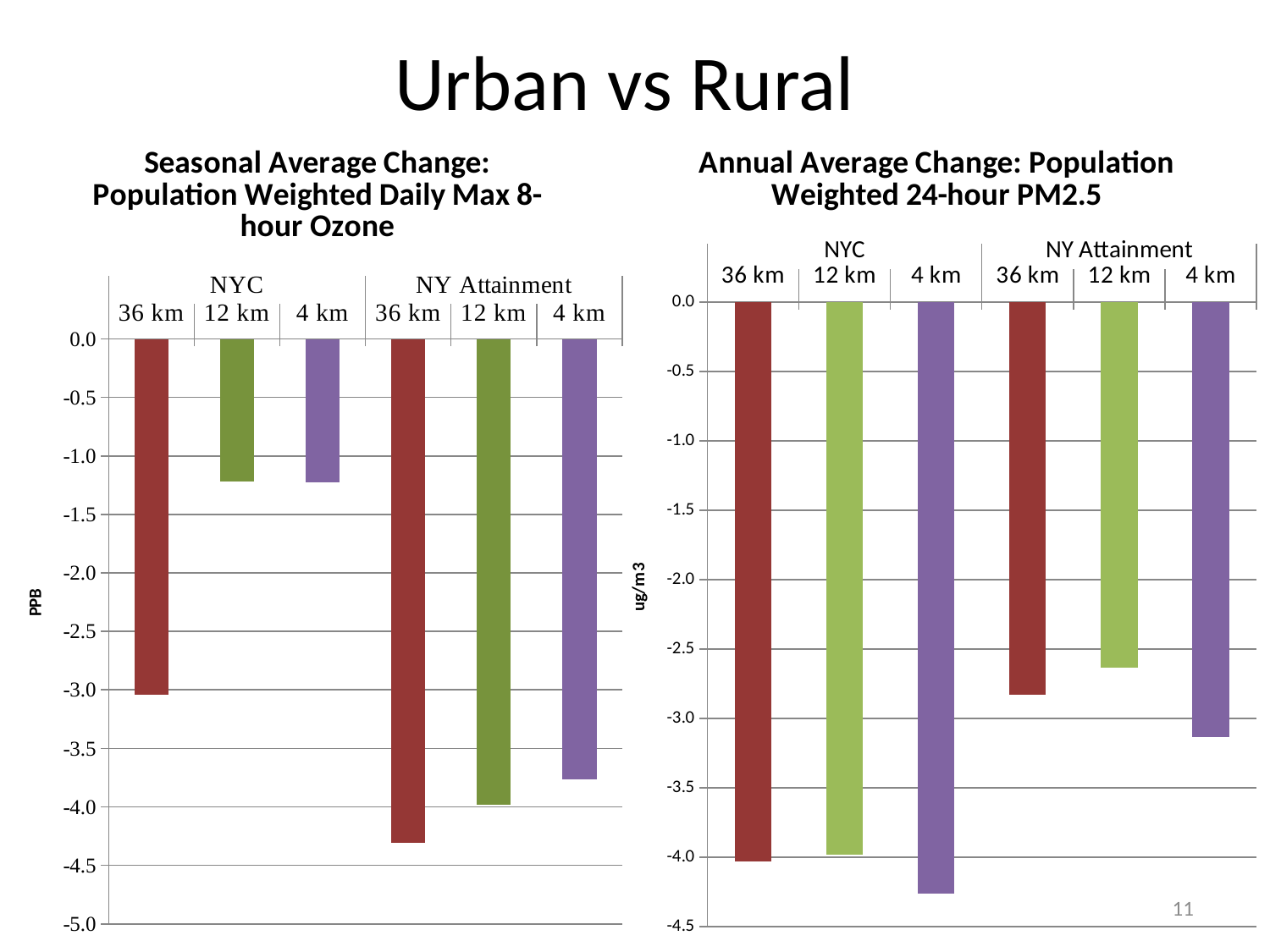
In the PM2.5 chart on the right, is the value for NYC 4 km greater or less than -4.0? less In the Ozone chart on the left, is the value for NY Attainment 36 km greater or less than -4.0? less In the PM2.5 chart on the right, is the value for NY Attainment 12 km greater or less than -3.0? greater In the Ozone chart on the left, which is larger, the value for NYC 12 km or the value for NY Attainment 12 km? NYC 12 km In the PM2.5 chart on the right, which is larger, the value for NYC 36 km or the value for NY Attainment 36 km? NY Attainment 36 km In the PM2.5 chart on the right, which bar has the lowest (most negative) value? NYC 4 km What kind of chart is the 'Seasonal Average Change: Population Weighted Daily Max 8-hour Ozone' chart? bar chart How many bars are plotted in the 'Annual Average Change: Population Weighted 24-hour PM2.5' chart? 6 In the Ozone chart on the left, which bar has the lowest (most negative) value? NY Attainment 36 km What unit is shown on the vertical axis of the PM2.5 chart on the right? ug/m3 In the PM2.5 chart on the right, which bar has the highest value (closest to zero)? NY Attainment 12 km